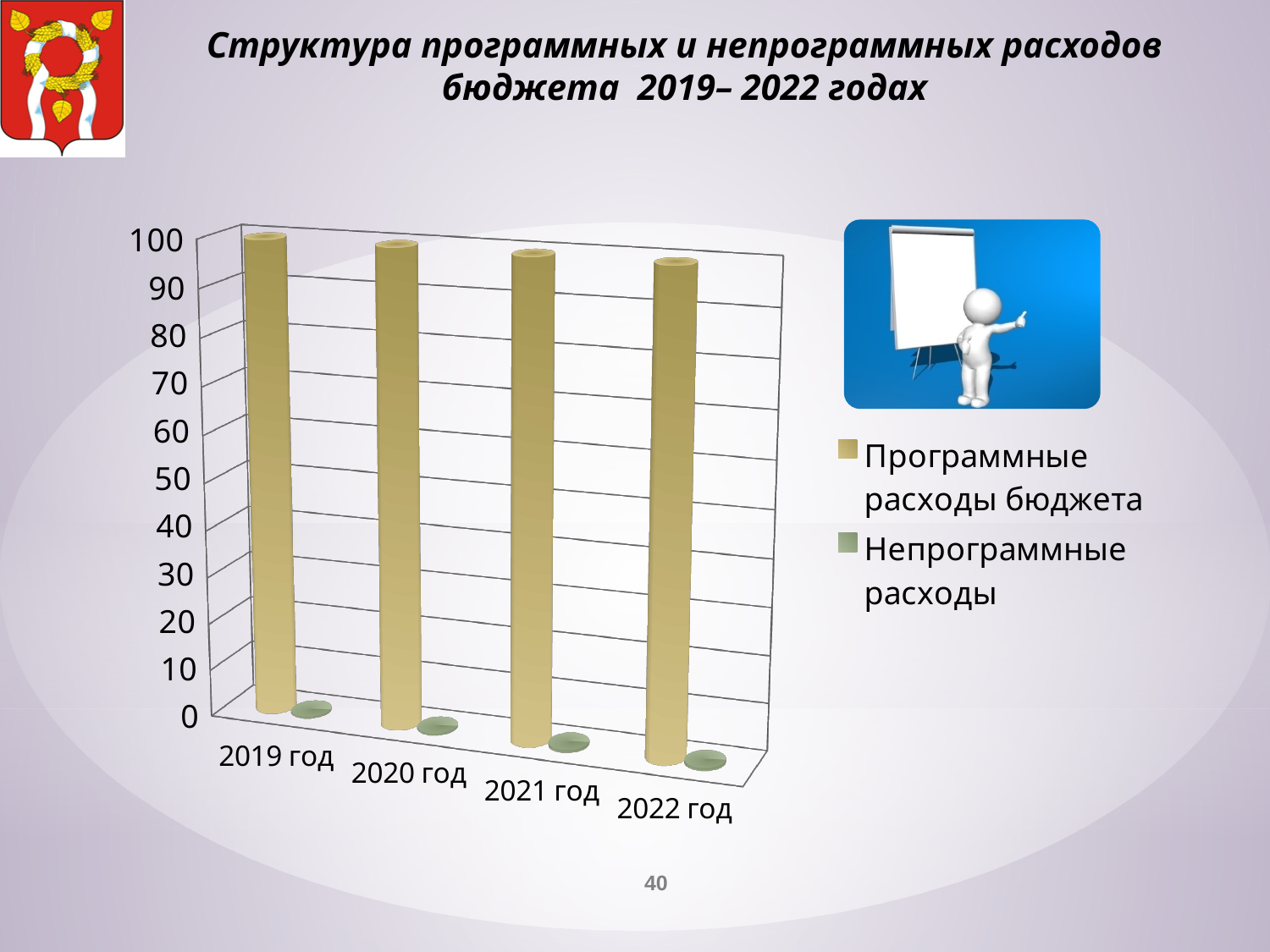
What is the title of the slide containing the chart? Структура программных и непрограммных расходов бюджета 2019– 2022 годах What kind of chart is shown on the slide? bar chart How many years (categories) are shown on the x axis of the chart? 4 Is the value for Программные расходы бюджета in 2022 год greater or less than 80? greater Is the value for Непрограммные расходы in 2022 год greater or less than 10? less Do the values for Программные расходы бюджета rise or fall from 2019 год to 2022 год? fall Which series is shown in green in the chart? Непрограммные расходы How many series does the chart legend list? 2 Is the value for Программные расходы бюджета in 2019 год greater or less than 90? greater In 2020 год, which is larger: Программные расходы бюджета or Непрограммные расходы? Программные расходы бюджета